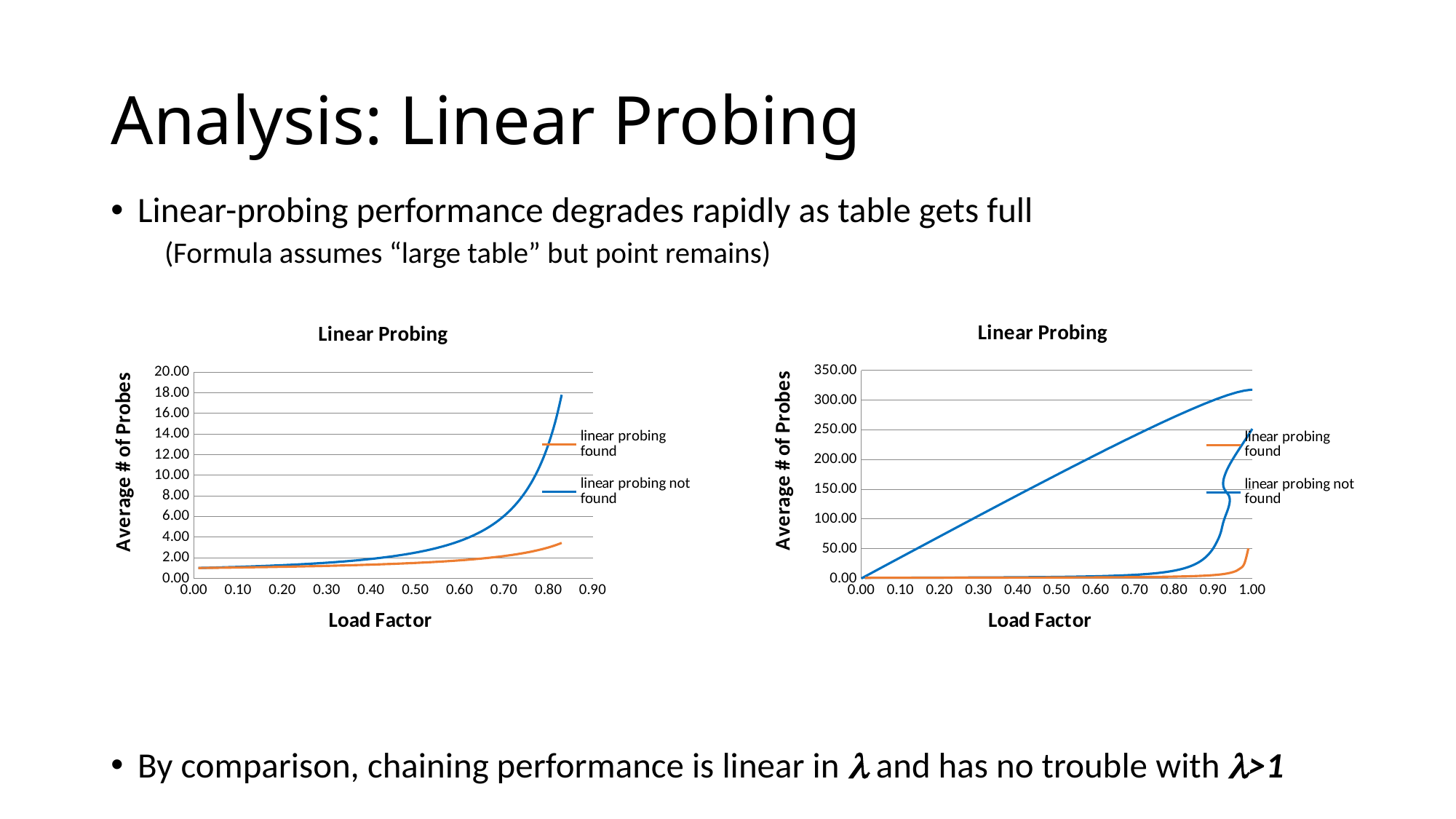
In the right chart, is the value of "linear probing found" at load factor 0.90 greater or less than 50.00? less In the left chart, is the value of "linear probing found" at load factor 0.80 greater or less than 4.00? less In the left chart, is the value of "linear probing not found" at load factor 0.80 greater or less than 10.00? greater In the left chart, does the "linear probing not found" line rise or fall as the load factor increases? rise What is the label of the y axis on the left chart? Average # of Probes How many series does the legend of the right chart list? 2 In the left chart, at load factor 0.80, which series has the larger value: "linear probing found" or "linear probing not found"? linear probing not found What kind of chart is the left chart titled "Linear Probing"? line chart In the right chart, does the "linear probing not found" line rise or fall as the load factor increases from 0.00 to 0.90? rise How many series does the legend of the left chart list? 2 What is the label of the x axis on the right chart? Load Factor